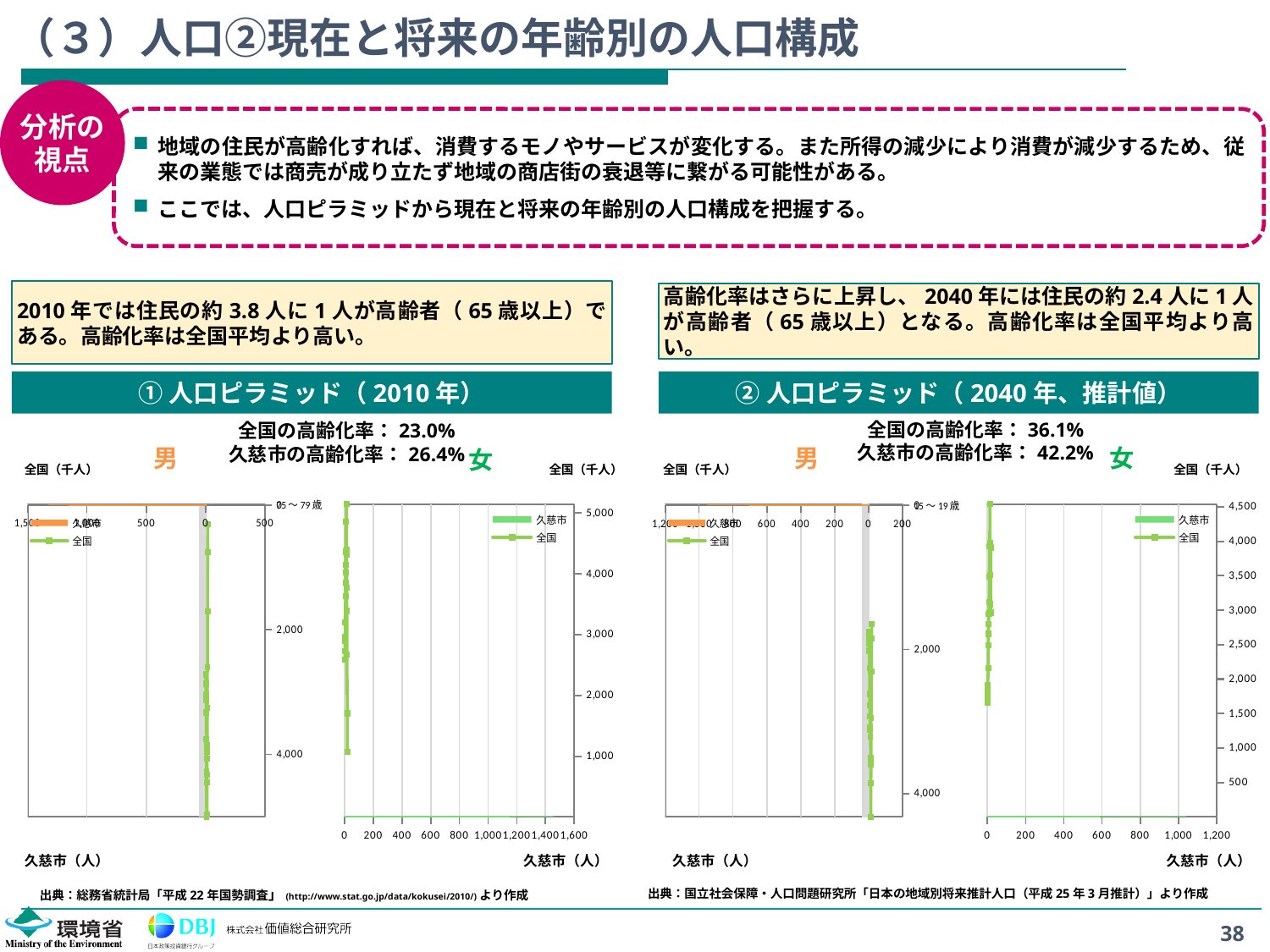
What are the two legend entries in the ② 人口ピラミッド（2040年、推計値） chart? 久慈市, 全国 In the ② 人口ピラミッド（2040年、推計値） chart, what is the aging rate for 久慈市 printed above the chart? 42.2% What is the highest tick on the right-hand vertical axis of the female (女) panel in the ① 人口ピラミッド（2010年） chart? 5,000 What is the difference between the 久慈市 aging rate and the national aging rate in the ① 人口ピラミッド（2010年） chart? 3.4% In the ② 人口ピラミッド（2040年、推計値） chart, what is the national aging rate (全国の高齢化率) printed above the chart? 36.1% In the ① 人口ピラミッド（2010年） chart, what is the national aging rate (全国の高齢化率) printed above the chart? 23.0% What is the highest tick on the horizontal axis of the female (女) panel in the ① 人口ピラミッド（2010年） chart? 1,600 What kind of chart is the ① 人口ピラミッド（2010年） chart? bar chart In the ② 人口ピラミッド（2040年、推計値） chart, which is higher, the aging rate for 久慈市 or the national aging rate? 久慈市 In the ① 人口ピラミッド（2010年） chart, what is the aging rate for 久慈市 printed above the chart? 26.4% What is the highest tick on the horizontal axis of the female (女) panel in the ② 人口ピラミッド（2040年、推計値） chart? 1,200 How many series does the legend of the ① 人口ピラミッド（2010年） chart list? 2